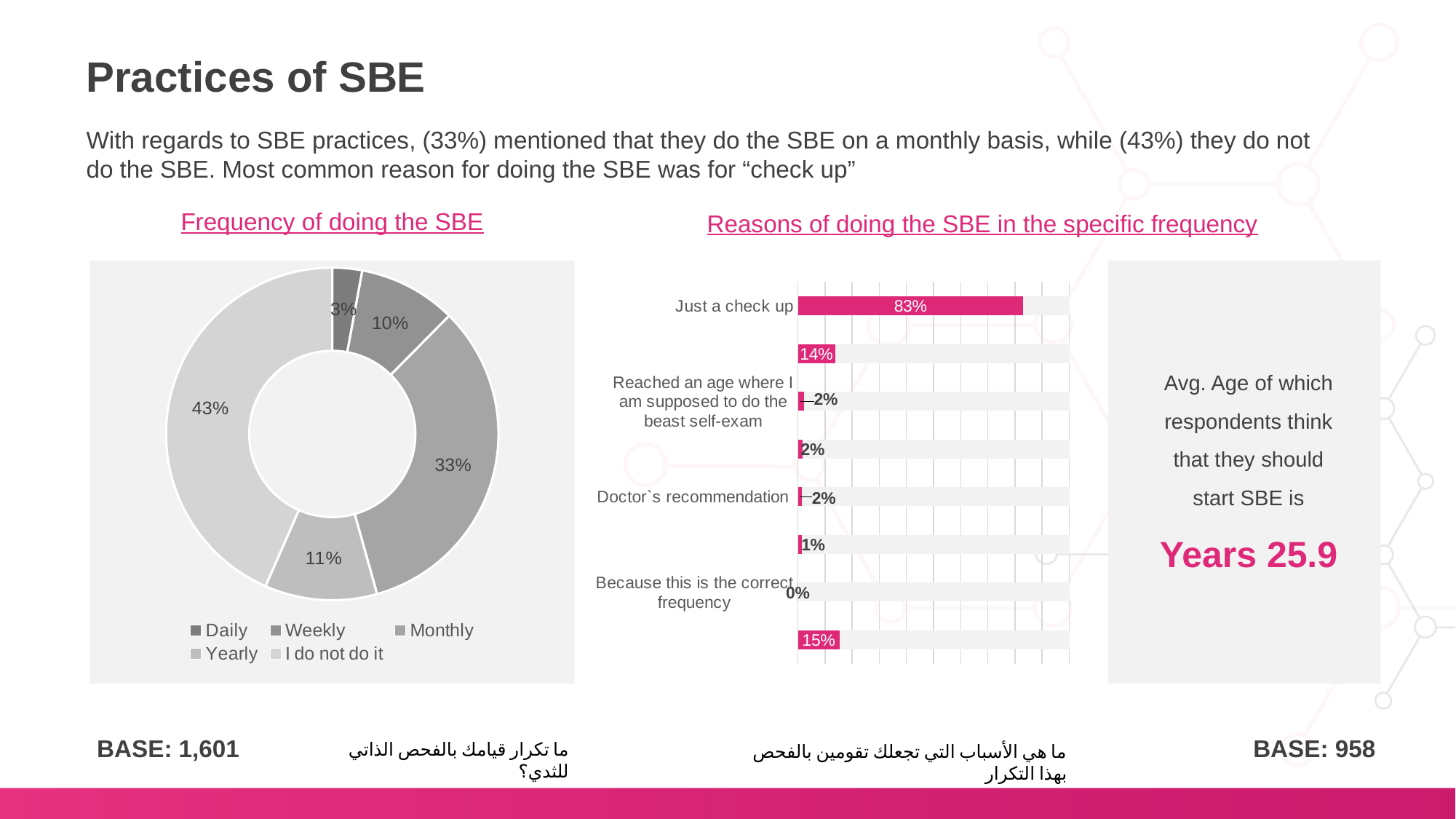
In the 'Frequency of doing the SBE' chart, what is the value for 'I do not do it'? 43% In the 'Reasons of doing the SBE in the specific frequency' chart, which reason has the highest value? Just a check up In the 'Frequency of doing the SBE' chart, which category has the smallest share? Daily In the 'Reasons of doing the SBE in the specific frequency' chart, what is the value for 'Because this is the correct frequency'? 0% In the 'Frequency of doing the SBE' chart, what percentage do the SBE monthly? 33% What kind of chart is the 'Frequency of doing the SBE' chart? Doughnut chart How many bars are plotted in the 'Reasons of doing the SBE in the specific frequency' chart? 8 In the 'Reasons of doing the SBE in the specific frequency' chart, what is the value for 'Just a check up'? 83% In the 'Frequency of doing the SBE' chart, which category has the largest share? I do not do it What kind of chart is the 'Reasons of doing the SBE in the specific frequency' chart? Bar chart In the 'Frequency of doing the SBE' chart, what is the difference between the Monthly and Yearly shares? 22% How many entries does the legend of the 'Frequency of doing the SBE' chart list? 5